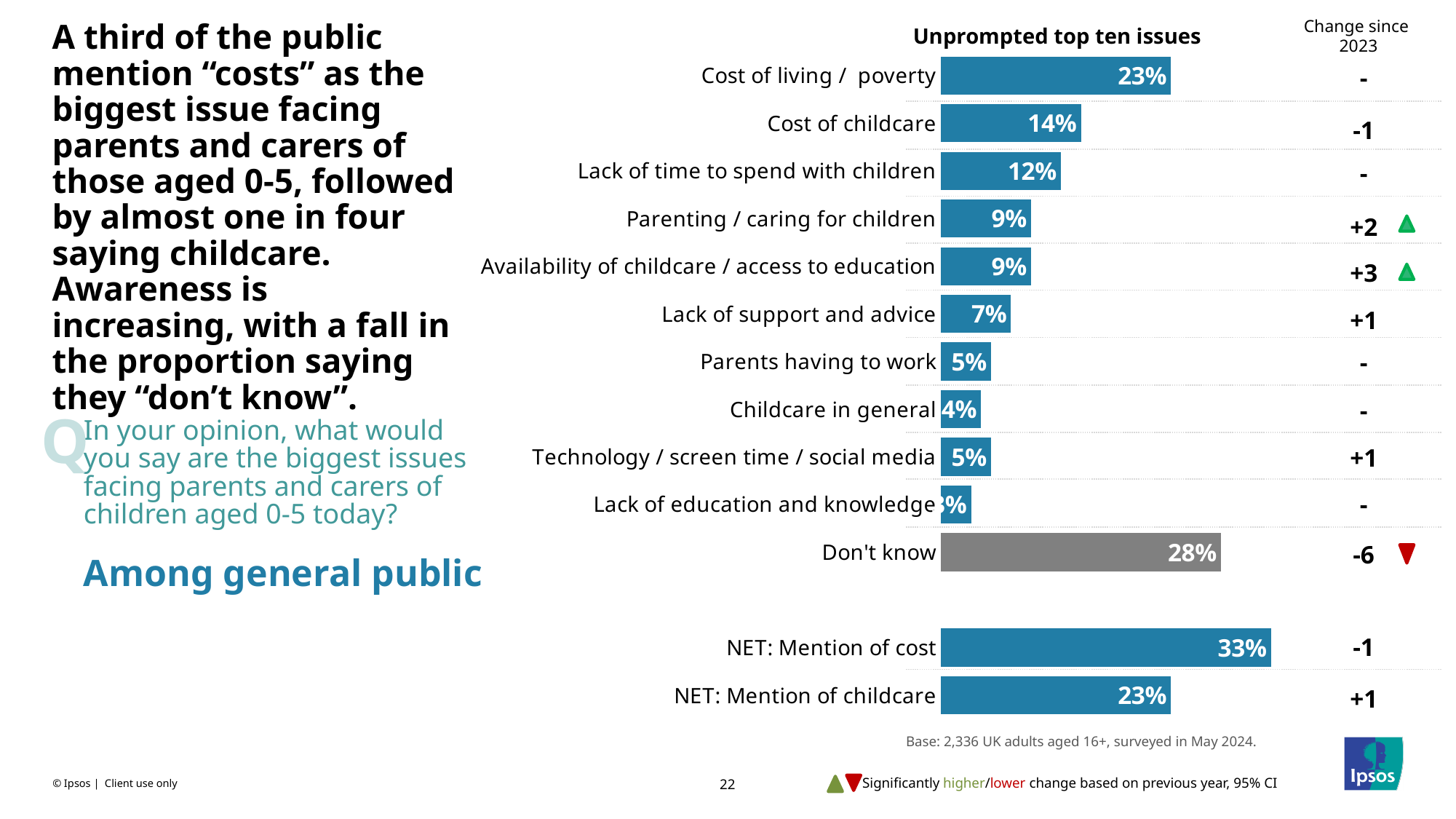
What is the value shown for Cost of childcare? 14% What is the change since 2023 shown for Don't know? -6 What is the difference between NET: Mention of cost and NET: Mention of childcare? 10 percentage points What kind of chart is shown on the slide? Bar chart Which of the unprompted top ten issues has the highest percentage? Cost of living / poverty What is the difference in percentage points between Cost of living / poverty and Cost of childcare? 9 percentage points Which is larger, Lack of time to spend with children or Lack of support and advice? Lack of time to spend with children What percentage is shown for Don't know? 28% How many issues are listed under the heading Unprompted top ten issues (excluding Don't know and the NET rows)? 10 What is the value for NET: Mention of cost? 33% Which is larger, the value for Don't know or the value for Cost of living / poverty? Don't know What percentage of the general public mention Cost of living / poverty as the biggest issue? 23%